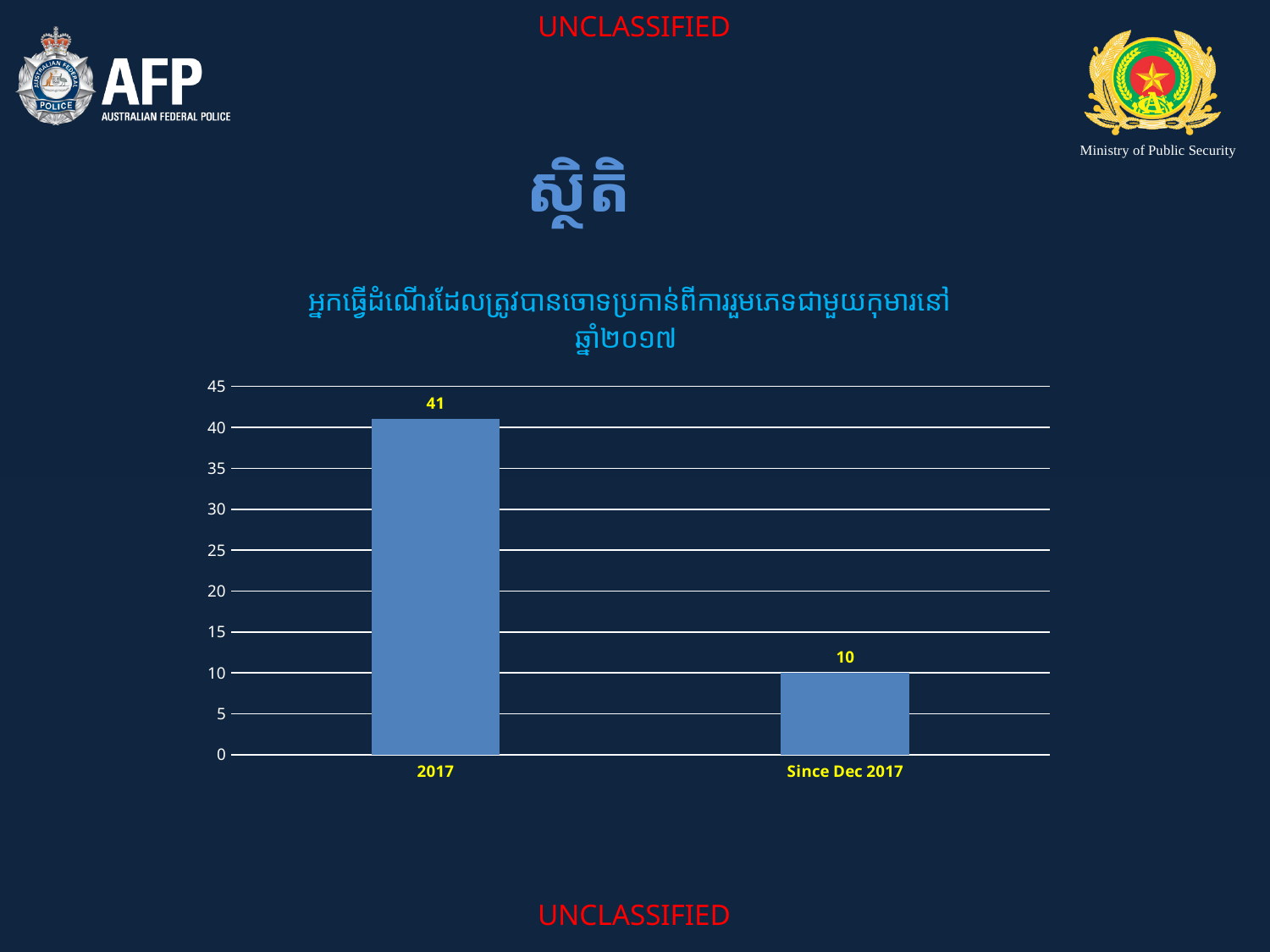
What is the highest value shown on the y axis? 45 Which category has the highest value? 2017 Is the value for Since Dec 2017 greater or less than 15? less Is the value for 2017 greater or less than 40? greater What kind of chart is shown on the slide? bar chart Which is larger, the value for 2017 or the value for Since Dec 2017? 2017 What is the value for 2017? 41 What is the difference between the values for 2017 and Since Dec 2017? 31 What is the value for Since Dec 2017? 10 What colour are the bars in the chart? blue Which category has the lowest value? Since Dec 2017 How many categories are shown on the x axis? 2